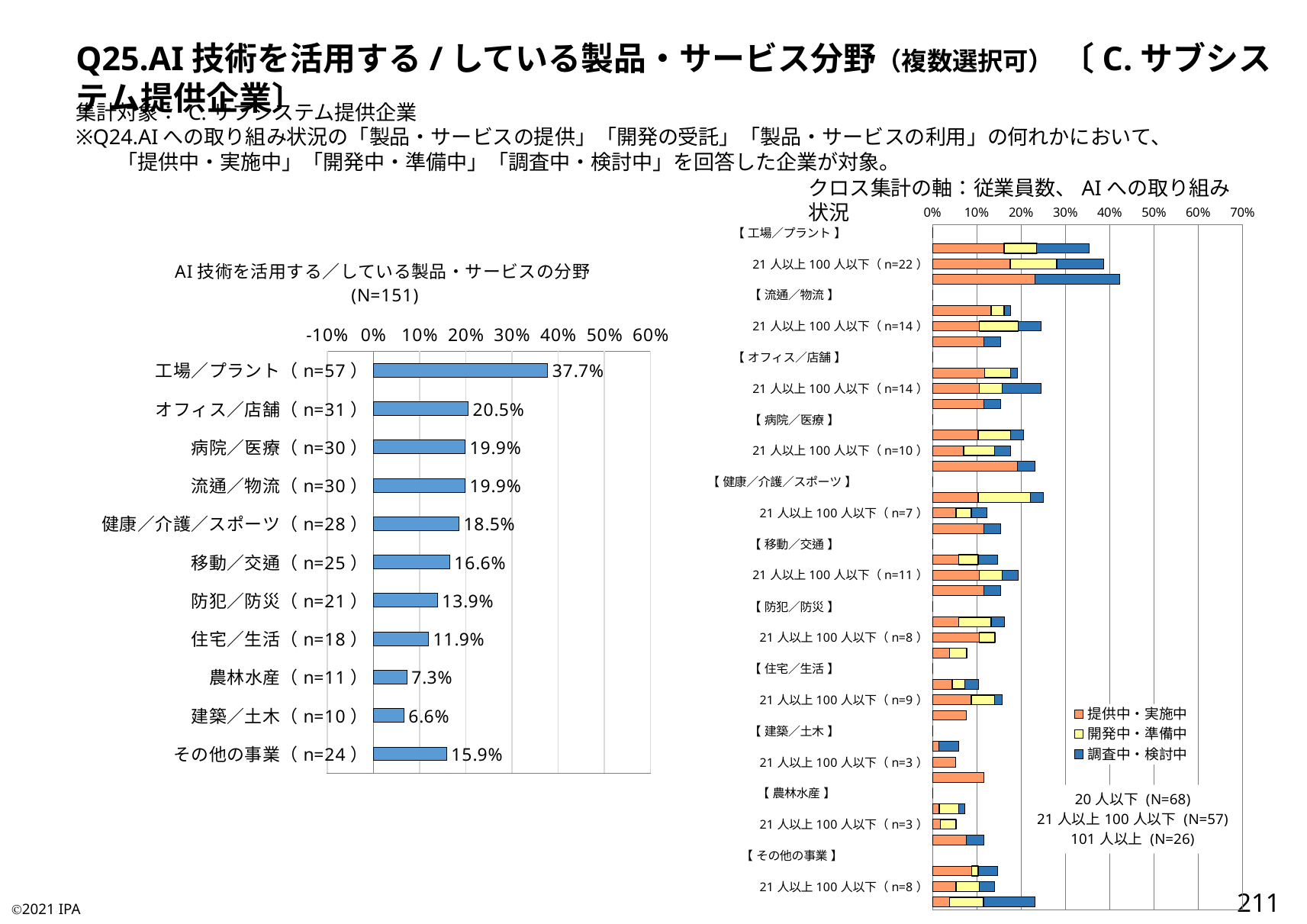
What kind of chart is the left chart? Bar chart In the left chart, which category has the highest value? 工場／プラント What is the N shown in the title of the left chart? N=151 In the left chart, which category has the lowest value? 建築／土木 In the left chart, what is the value for その他の事業? 15.9% In the left chart (AI技術を活用する／している製品・サービスの分野), what is the value for 工場／プラント? 37.7% How many categories are shown in the left chart? 11 In the left chart, which is larger: the value for 移動／交通 or the value for 防犯／防災? 移動／交通 In the left chart, what is the difference between the values for 工場／プラント and オフィス／店舗? 17.2% How many series does the legend of the right chart list? 3 In the right chart, is the total stacked value for the 21人以上100人以下 (n=22) bar under 工場／プラント greater or less than 30%? greater In the left chart, what is the value for 健康／介護／スポーツ? 18.5%